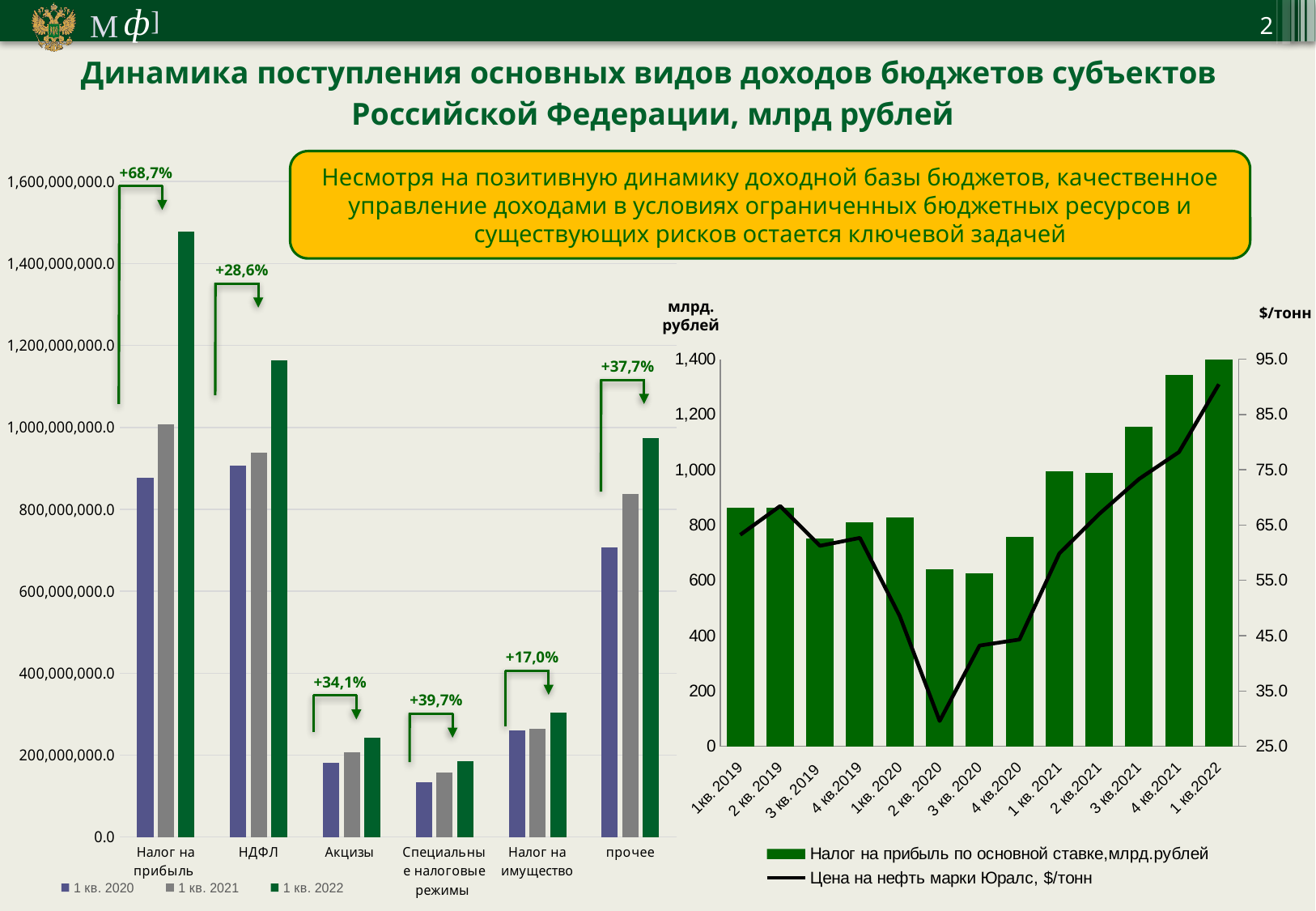
What kind of chart is the left chart showing revenue types by quarter? bar chart On the left chart, what growth percentage is printed above the НДФЛ group? +28,6% On the right chart, in which quarter does the Цена на нефть марки Юралс line reach its lowest point? 2 кв. 2020 On the left chart, what growth percentage is printed above the Налог на прибыль group? +68,7% On the left chart, what growth percentage is printed above the Налог на имущество group? +17,0% How many series does the legend of the left chart list? 3 On the right chart, how many quarters are shown on the x axis? 13 On the left chart, is the 1 кв. 2022 value for Налог на прибыль greater or less than 1,400,000,000.0? greater How many revenue categories are shown on the x axis of the left chart? 6 On the left chart, which category has the lowest 1 кв. 2022 bar? Специальные налоговые режимы On the right chart, which quarter has the highest bar for Налог на прибыль по основной ставке? 1 кв. 2022 On the left chart, which category has the highest 1 кв. 2022 bar? Налог на прибыль